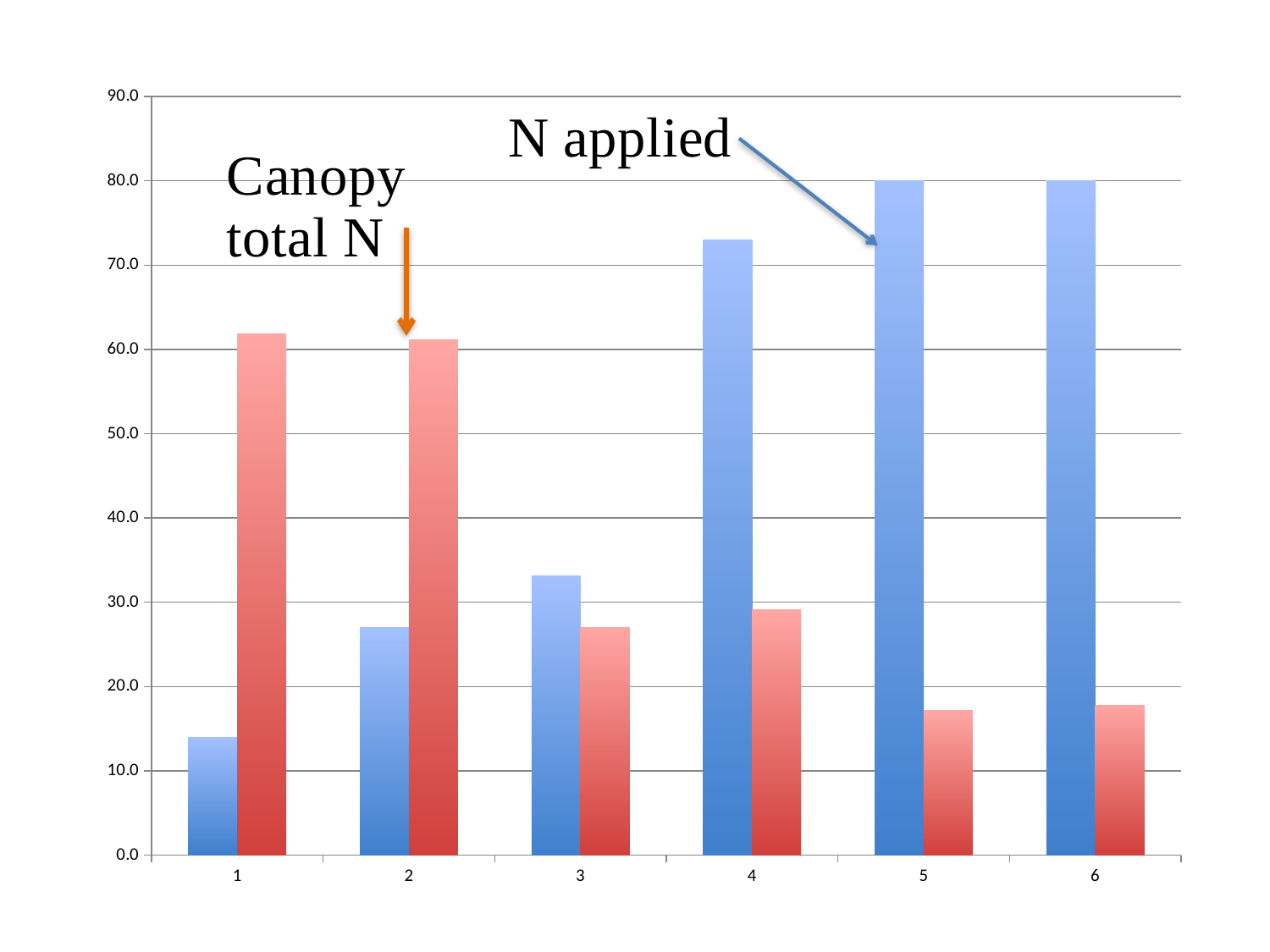
What is the value of N applied for category 6? 80.0 Does the value of N applied rise or fall from category 1 to category 6? rise What is the value of N applied for category 5? 80.0 Is the value of Canopy total N for category 5 greater or less than 20.0? less What kind of chart is shown on the slide? bar chart Which category has the lowest value of N applied? 1 Is the value of Canopy total N for category 1 greater or less than 60.0? greater Is the value of N applied for category 1 greater or less than 20.0? less How many categories are shown on the x axis? 6 For category 1, which is larger: N applied or Canopy total N? Canopy total N How many data series are plotted in the chart? 2